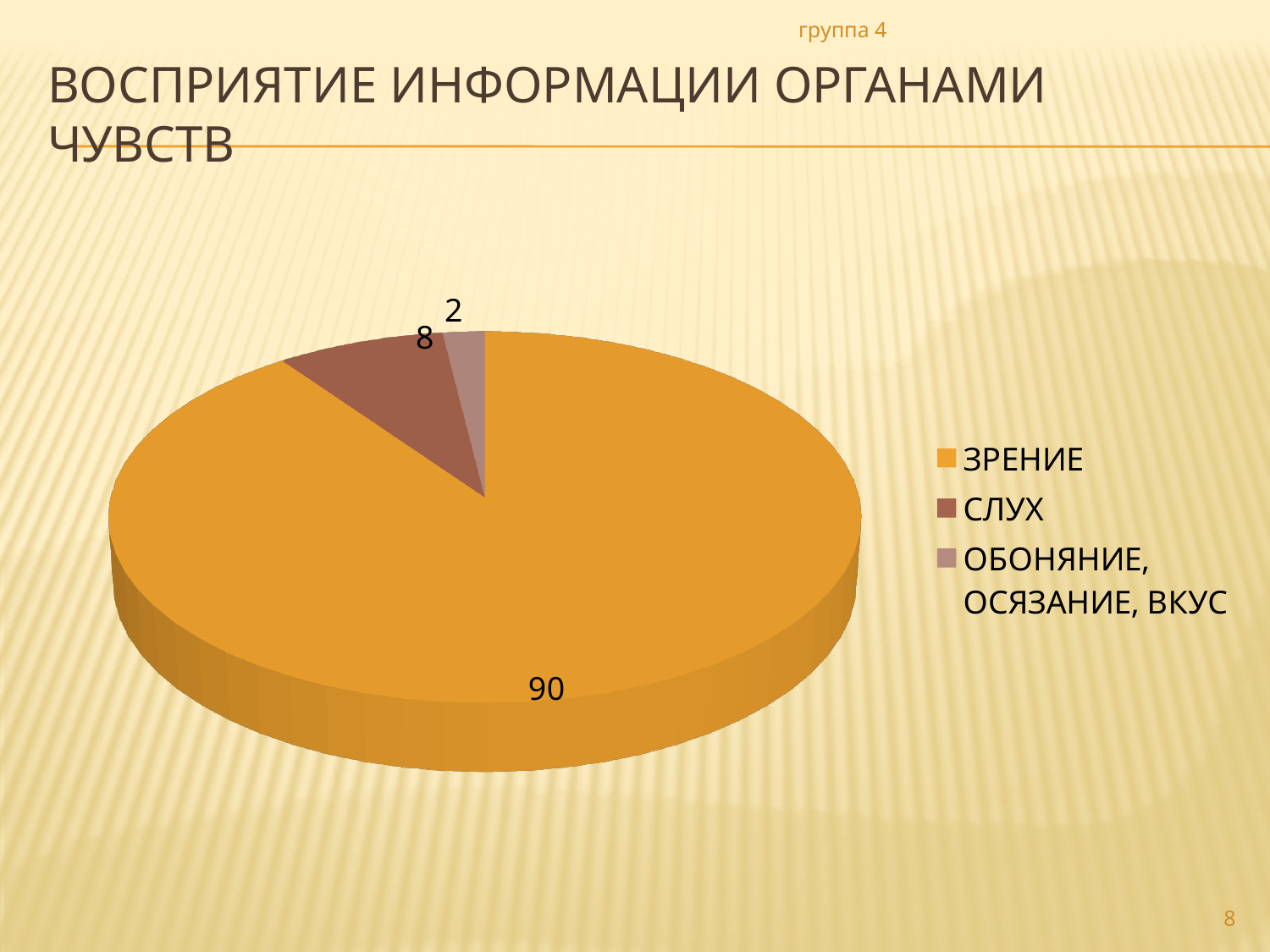
How many slices does the pie chart have? 3 What is the difference between the values for СЛУХ and ОБОНЯНИЕ, ОСЯЗАНИЕ, ВКУС? 6 What is the value for ЗРЕНИЕ? 90 What is the value for ОБОНЯНИЕ, ОСЯЗАНИЕ, ВКУС? 2 Which category has the largest slice? ЗРЕНИЕ What is the value for СЛУХ? 8 What colour is the slice for ЗРЕНИЕ? orange Which is larger, the value for СЛУХ or the value for ОБОНЯНИЕ, ОСЯЗАНИЕ, ВКУС? СЛУХ What is the difference between the values for ЗРЕНИЕ and СЛУХ? 82 Which category has the smallest slice? ОБОНЯНИЕ, ОСЯЗАНИЕ, ВКУС What share of the pie does ЗРЕНИЕ represent? 90% What kind of chart is shown on the slide? pie chart